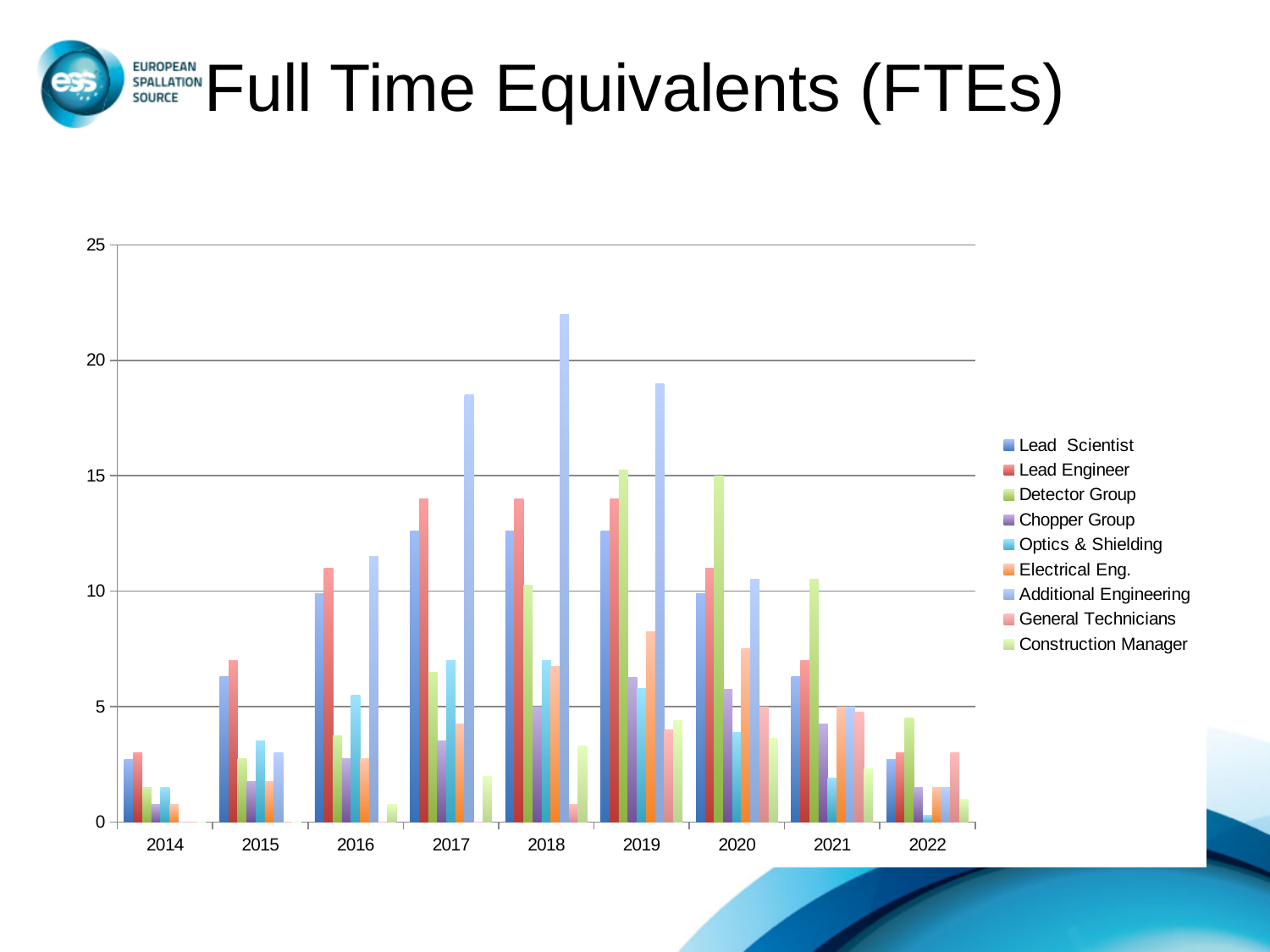
What kind of chart is shown on the slide? bar chart How many years are shown along the x axis? 9 What is the title of the chart? Full Time Equivalents (FTEs) Is the value for Lead Engineer in 2017 greater or less than 10? greater Does the Additional Engineering series rise or fall from 2018 to 2022? fall Is the value for Additional Engineering in 2018 greater or less than 20? greater Is the value for Electrical Eng. in 2019 greater or less than 10? less In which year is the Additional Engineering bar the tallest? 2018 In which year is the Additional Engineering bar the shortest? 2014 In 2020, which is larger: Detector Group or Lead Engineer? Detector Group How many series does the legend list? 9